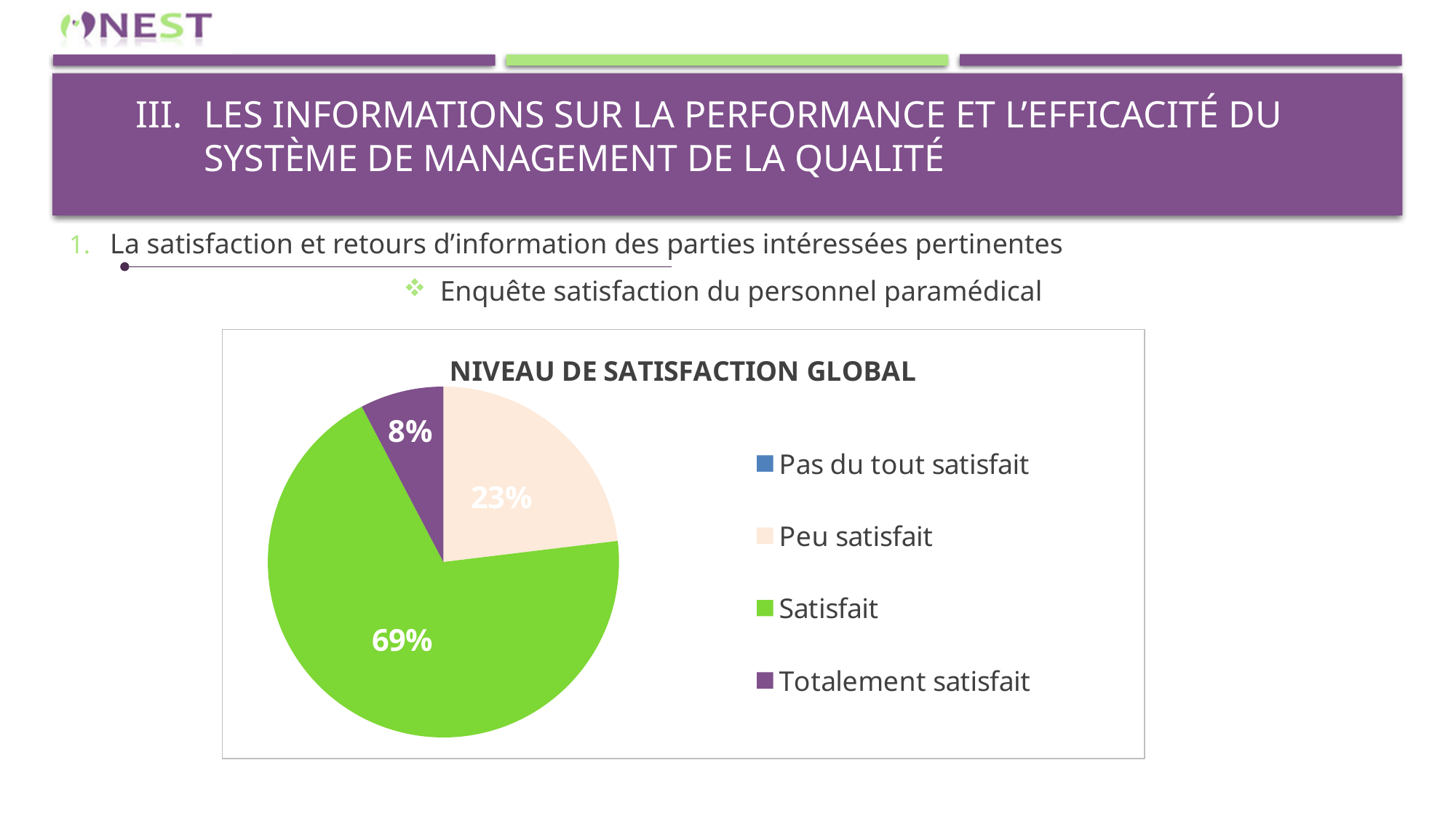
Which is larger, the slice for 'Peu satisfait' or the slice for 'Totalement satisfait'? Peu satisfait What is the difference in percentage points between 'Peu satisfait' and 'Totalement satisfait'? 15 How many entries does the chart legend list? 4 Which of the labelled slices is the smallest? Totalement satisfait What kind of chart is shown on the slide? pie chart What percentage of the pie is labelled for 'Totalement satisfait'? 8% Which category has the largest slice of the pie? Satisfait What is the difference in percentage points between 'Satisfait' and 'Peu satisfait'? 46 What is the title of the chart? NIVEAU DE SATISFACTION GLOBAL What percentage of the pie is labelled for 'Peu satisfait'? 23% What colour is the slice for 'Satisfait'? green What percentage of the pie is labelled for 'Satisfait'? 69%